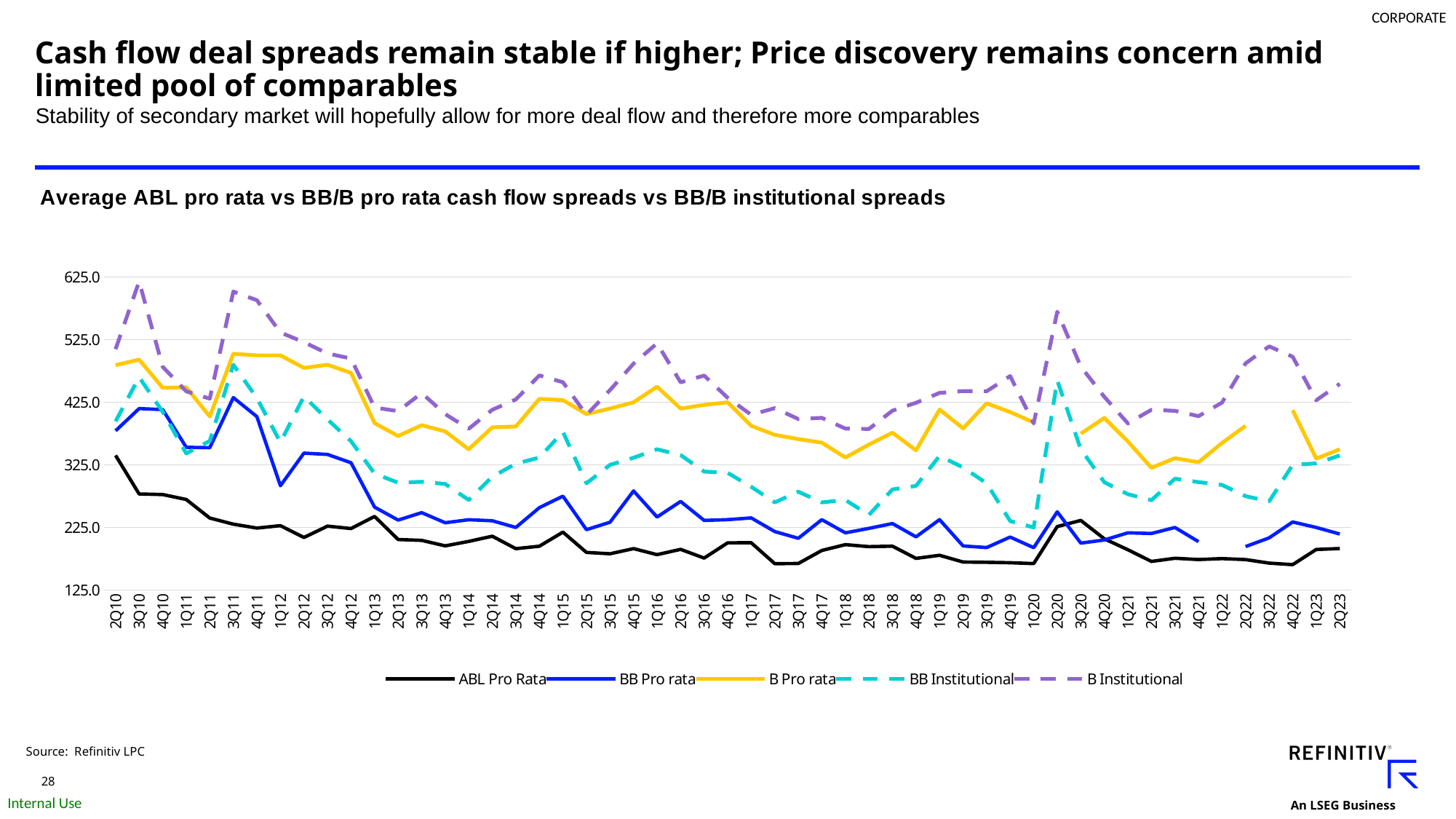
What is the title of the chart? Average ABL pro rata vs BB/B pro rata cash flow spreads vs BB/B institutional spreads Is the value for B Institutional in 3Q10 greater or less than 525.0? greater What kind of chart is shown on the slide? line chart Overall, does the ABL Pro Rata line rise or fall from 2Q10 to 2Q23? fall In 3Q10, which is higher: B Institutional or B Pro rata? B Institutional Which two series are drawn with dashed lines? BB Institutional and B Institutional How many series does the legend list? 5 In 2Q23, which is higher: B Institutional or ABL Pro Rata? B Institutional Is the value for BB Institutional in 2Q20 greater or less than 425.0? greater Which series has the highest value in 2Q10? B Institutional Is the value for ABL Pro Rata in 2Q23 greater or less than 225.0? less